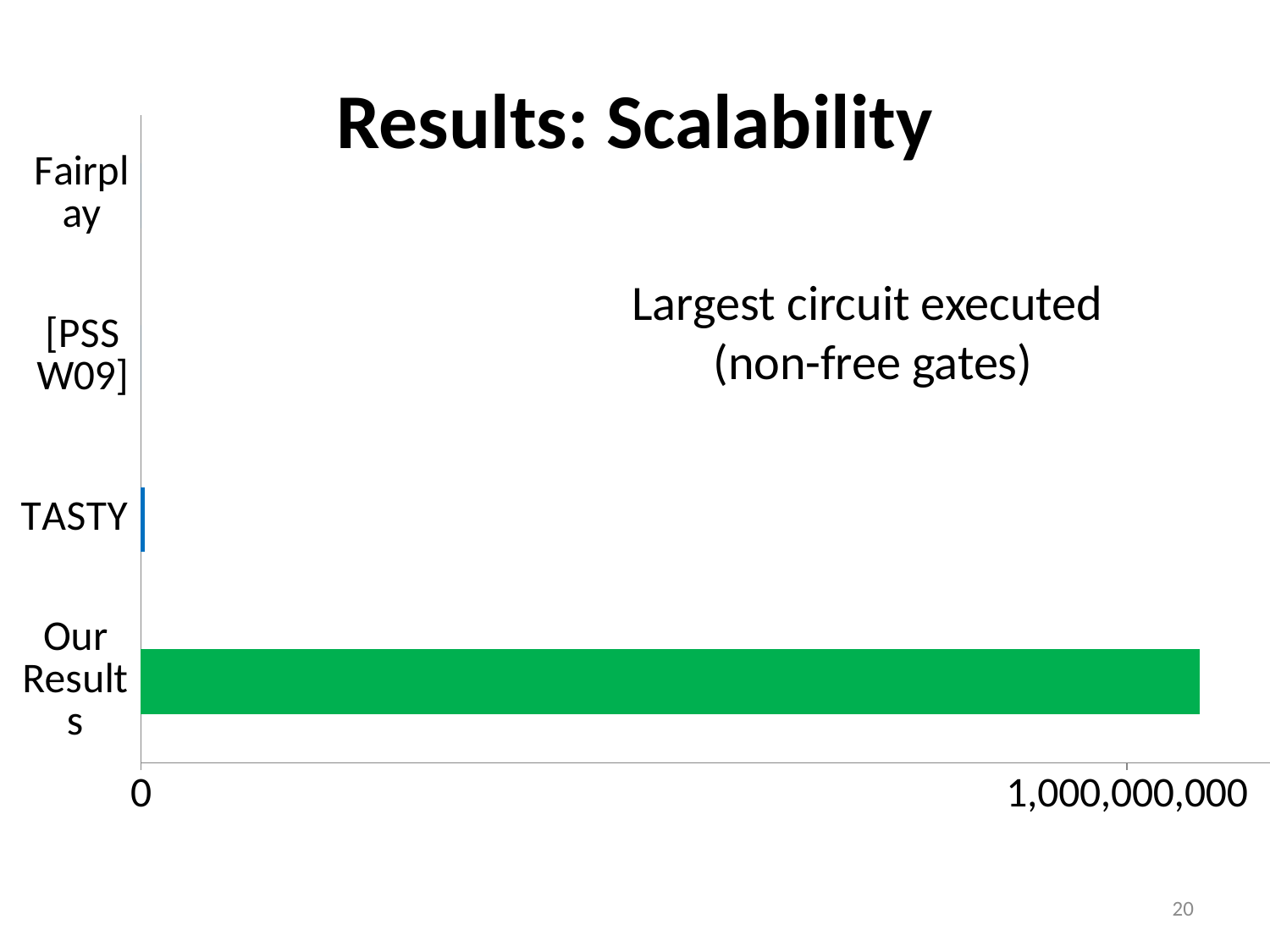
Is the value for Our Results greater or less than 1,000,000,000? greater Which has a larger value, Our Results or TASTY? Our Results What kind of chart is shown on the slide? bar chart How many categories are shown on the chart's vertical axis? 4 Which category has the largest bar in the chart? Our Results Is the value for TASTY greater or less than 1,000,000,000? less What is the title of the slide containing the chart? Results: Scalability What is the highest tick value shown on the horizontal axis? 1,000,000,000 What quantity does the chart measure, according to the text on the chart? Largest circuit executed (non-free gates)